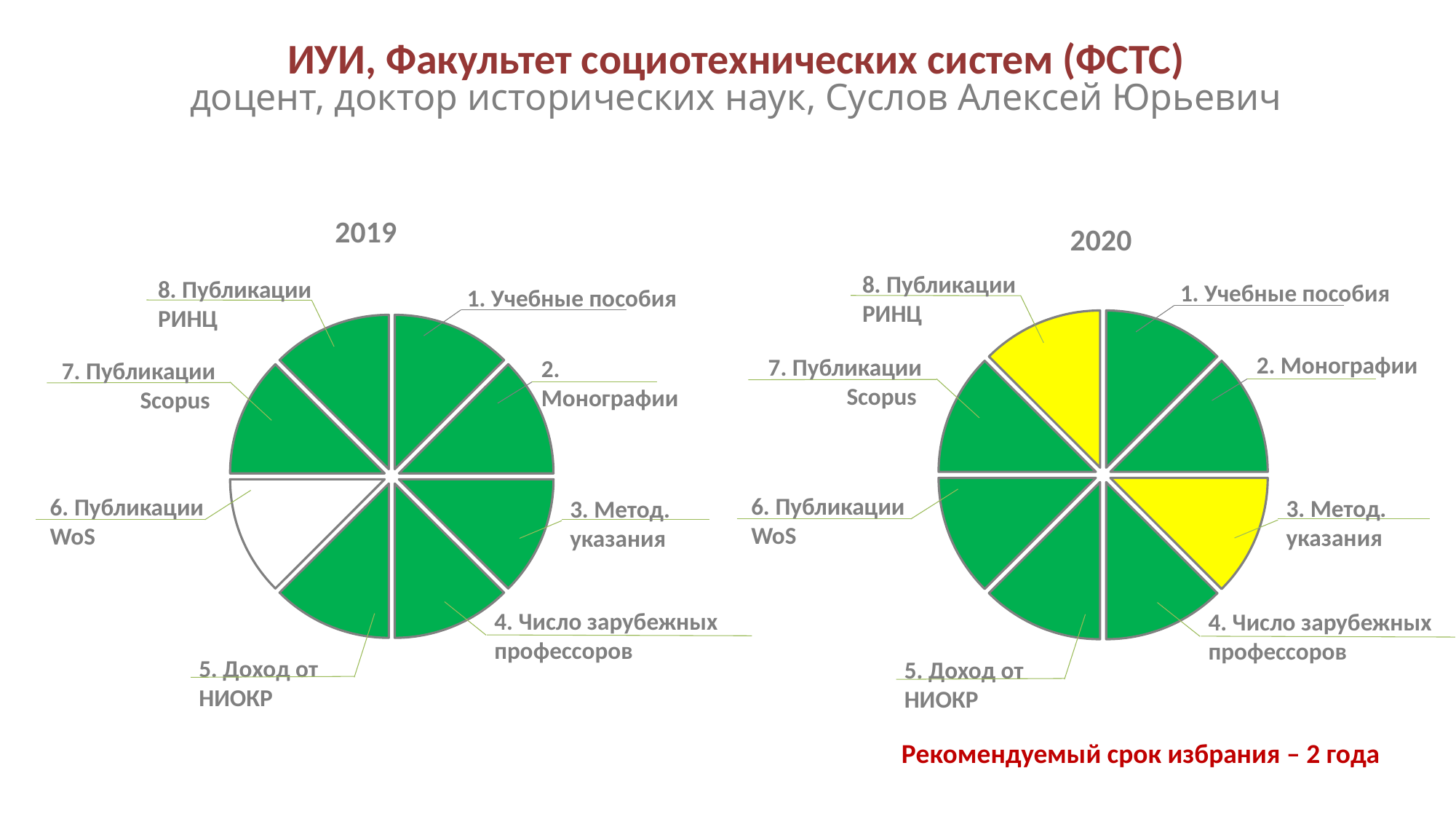
How many pie charts are shown on the slide? 2 In the 2019 pie chart, which slice is white rather than green? 6. Публикации WoS What kind of chart is the chart titled 2019? pie chart In the 2019 pie chart, what is the label of slice number 4? 4. Число зарубежных профессоров What kind of chart is the chart titled 2020? pie chart What is the title of the pie chart on the right side of the slide? 2020 How many slices does the 2019 pie chart have? 8 In the 2020 pie chart, which slices are coloured yellow? 3. Метод. указания and 8. Публикации РИНЦ In the 2020 pie chart, what is the label of slice number 5? 5. Доход от НИОКР How many slices does the 2020 pie chart have? 8